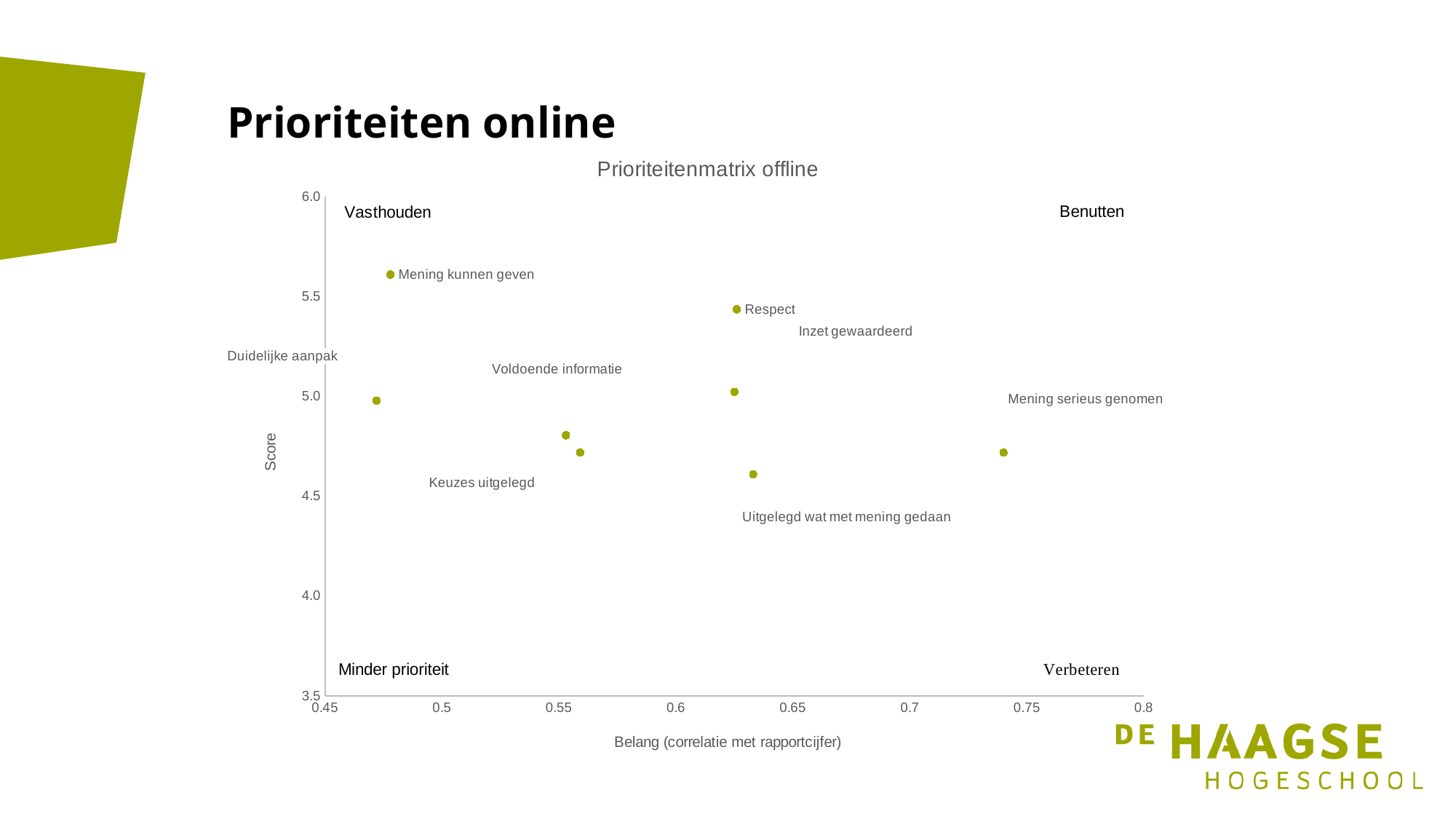
Which item has the lowest score in the chart? Uitgelegd wat met mening gedaan What is the title of the chart? Prioriteitenmatrix offline Is the Belang value for Mening serieus genomen greater or less than 0.7? greater What is the label of the horizontal axis of the chart? Belang (correlatie met rapportcijfer) Which has a higher score, Mening kunnen geven or Respect? Mening kunnen geven What type of chart is shown on the slide? Scatter chart How many data points are plotted in the chart? 8 Is the score for Respect greater or less than 5.5? less Is the Belang value for Duidelijke aanpak greater or less than 0.5? less Which item has the highest value on the Belang (correlatie met rapportcijfer) axis? Mening serieus genomen Which item has the highest score in the chart? Mening kunnen geven